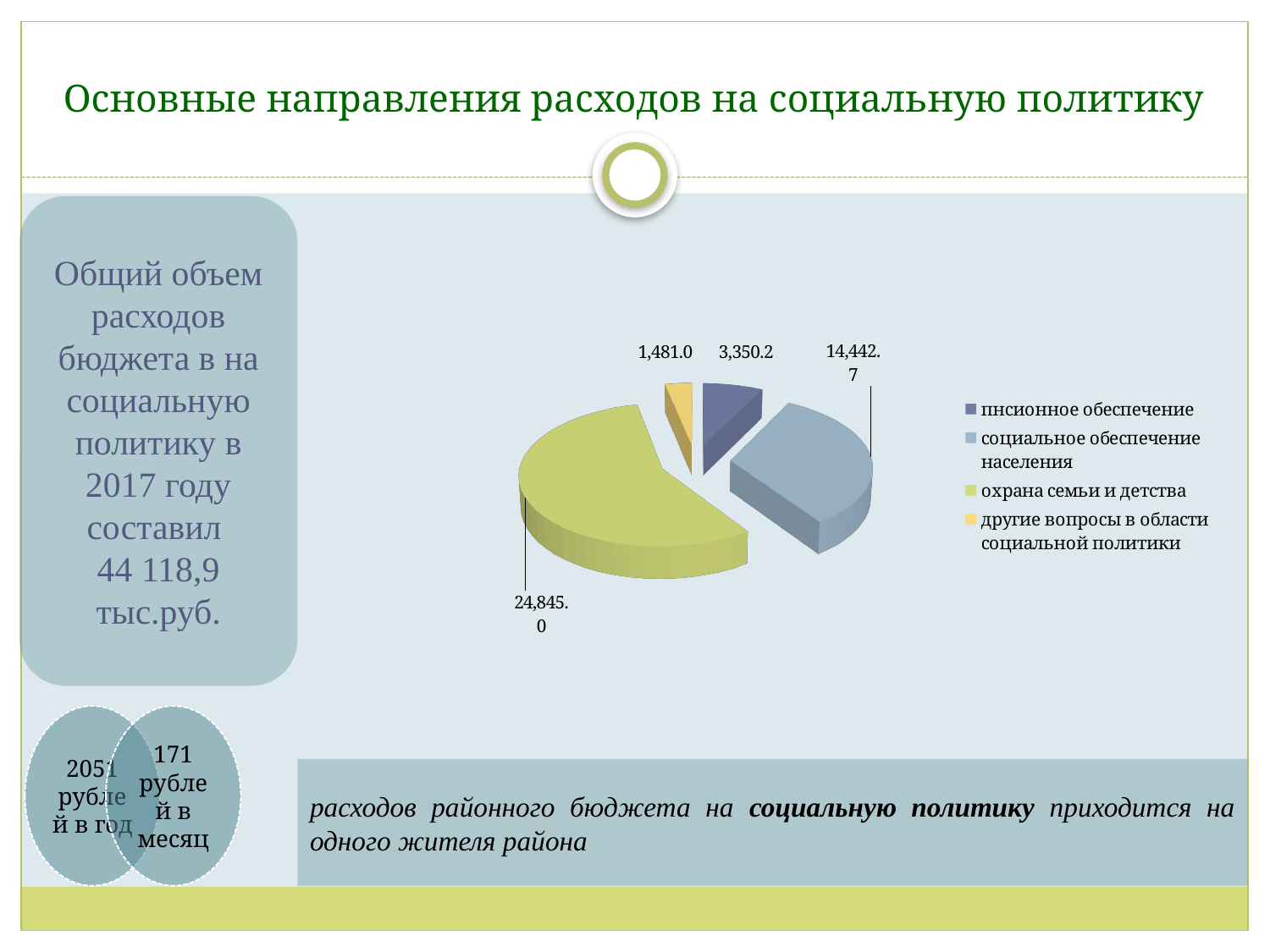
How many slices does the pie chart have? 4 What value is shown for the slice "другие вопросы в области социальной политики"? 1,481.0 Which category has the smallest slice of the pie? другие вопросы в области социальной политики What colour is the slice for "охрана семьи и детства"? green What kind of chart is shown on the slide? pie chart What is the difference between the values for "охрана семьи и детства" and "социальное обеспечение населения"? 10,402.3 Which is larger, the value for "социальное обеспечение населения" or the value for "пнсионное обеспечение"? социальное обеспечение населения What value is shown for the slice "социальное обеспечение населения"? 14,442.7 What value is shown for the slice "охрана семьи и детства"? 24,845.0 Which category has the largest slice of the pie? охрана семьи и детства What value is shown for the slice "пнсионное обеспечение"? 3,350.2 What is the difference between the values for "пнсионное обеспечение" and "другие вопросы в области социальной политики"? 1,869.2